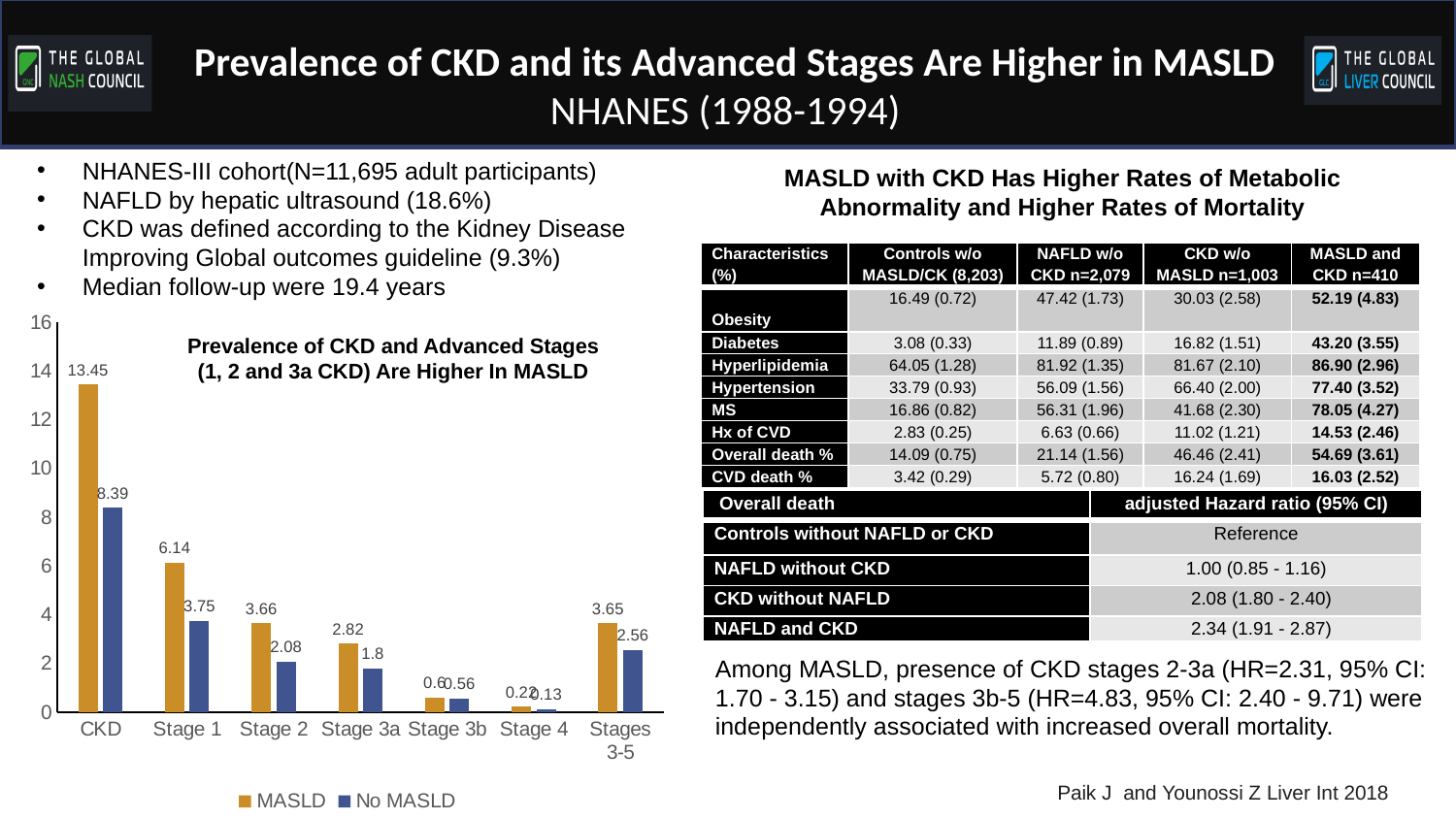
In the bar chart, which is larger for Stage 2: the MASLD value or the No MASLD value? MASLD What is the No MASLD value for Stage 3a in the bar chart? 1.8 What is the MASLD value for Stages 3-5 in the bar chart? 3.65 What is the difference between the MASLD and No MASLD values for CKD in the bar chart? 5.06 What is the MASLD value for CKD in the bar chart? 13.45 What is the MASLD value for Stage 1 in the bar chart? 6.14 What is the No MASLD value for CKD in the bar chart? 8.39 What type of chart is used to show the prevalence of CKD and advanced stages? Bar chart Which category has the highest MASLD value in the bar chart? CKD Which series is shown in blue in the bar chart? No MASLD How many series does the legend of the bar chart list? 2 How many categories are shown on the x axis of the bar chart? 7